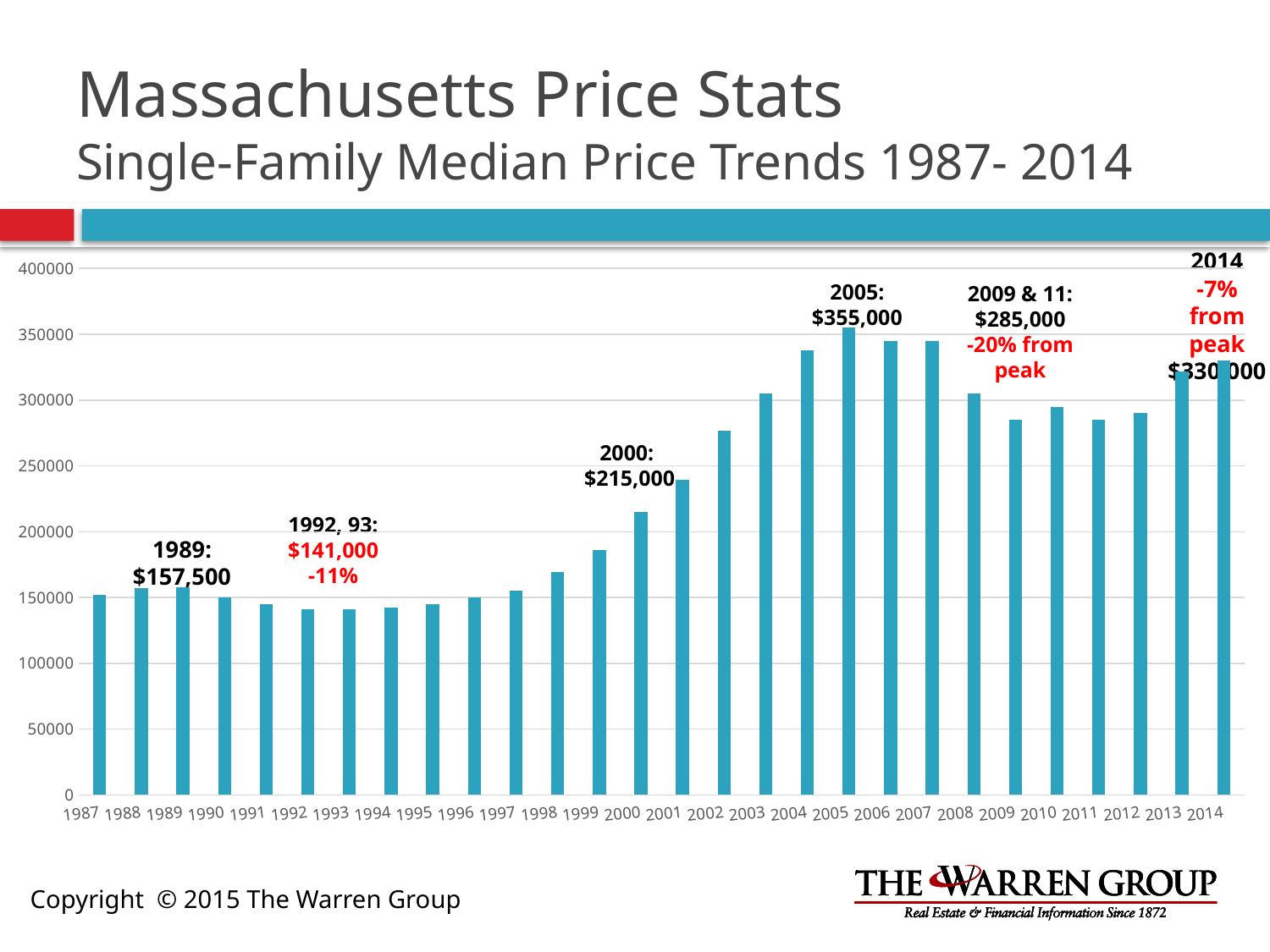
Which year has the highest median price? 2005 Which is larger, the median price in 2000 or in 1989? 2000 What is the difference between the 2005 median price and the 2014 median price? $25,000 What was the median price in 2005? $355,000 What is the difference between the 2005 median price and the 2009 median price? $70,000 Is the value for 2002 greater or less than 300000? less What kind of chart is shown on the slide? Bar chart Is the value for 2004 greater or less than 300000? greater How many years are shown on the x axis? 28 What was the median price in 2014? $330,000 What was the median price in 2000? $215,000 What was the Massachusetts single-family median price in 1989? $157,500